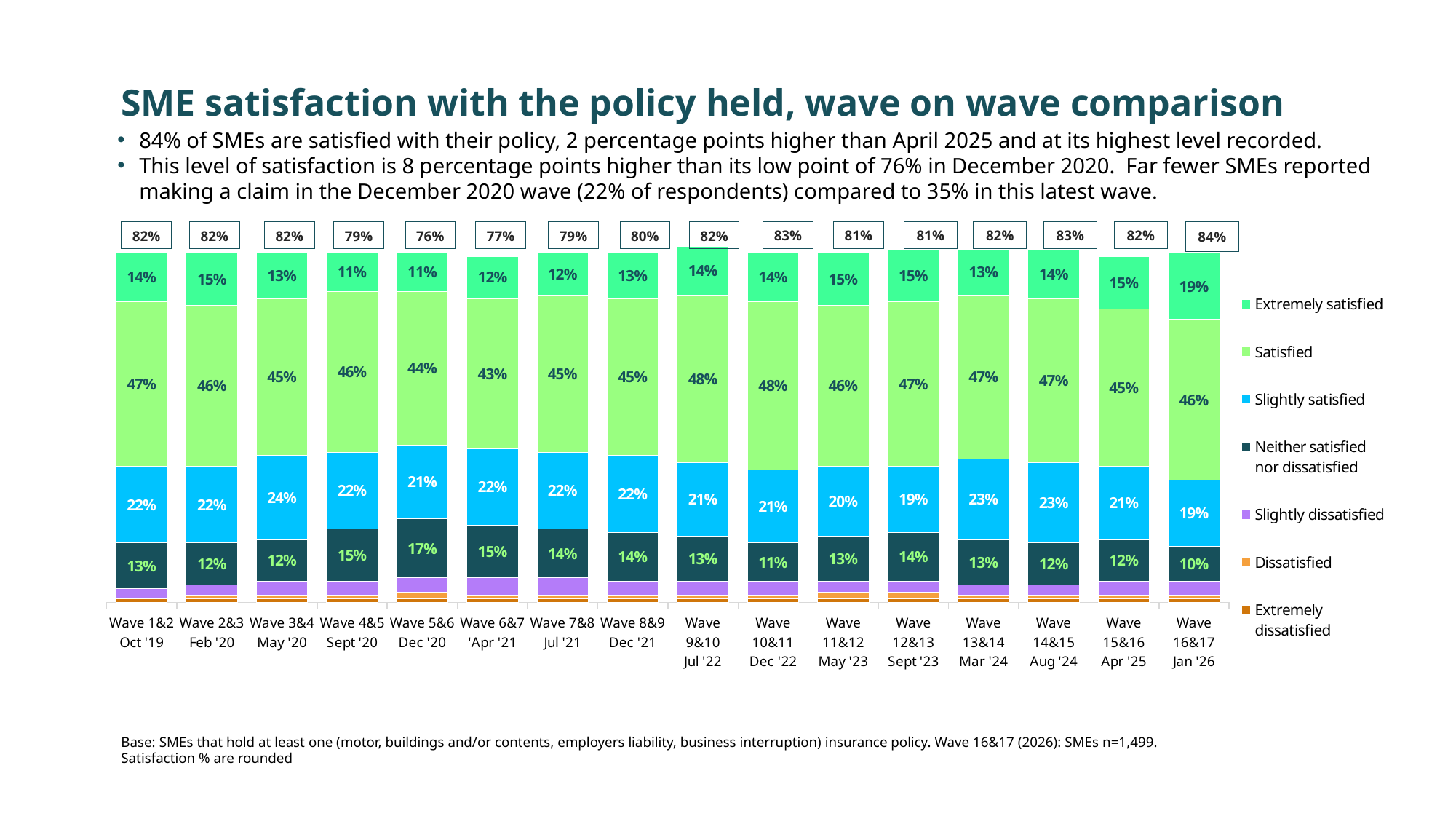
What is the overall satisfaction percentage shown in the box above Wave 5&6 Dec '20? 76% What is the difference between the Satisfied value for Wave 1&2 Oct '19 and Wave 6&7 'Apr '21? 4 percentage points Which wave has the lowest Neither satisfied nor dissatisfied value? Wave 16&17 Jan '26 What kind of chart is shown on the slide? Stacked bar chart What is the Neither satisfied nor dissatisfied value for Wave 5&6 Dec '20? 17% Which wave has the highest Extremely satisfied value? Wave 16&17 Jan '26 What is the Extremely satisfied value for Wave 16&17 Jan '26? 19% Which has the larger Slightly satisfied value, Wave 12&13 Sept '23 or Wave 13&14 Mar '24? Wave 13&14 Mar '24 How many waves (bars) are plotted on the chart? 16 What is the Satisfied value for Wave 9&10 Jul '22? 48% How many series does the legend list? 7 What is the Slightly satisfied value for Wave 3&4 May '20? 24%